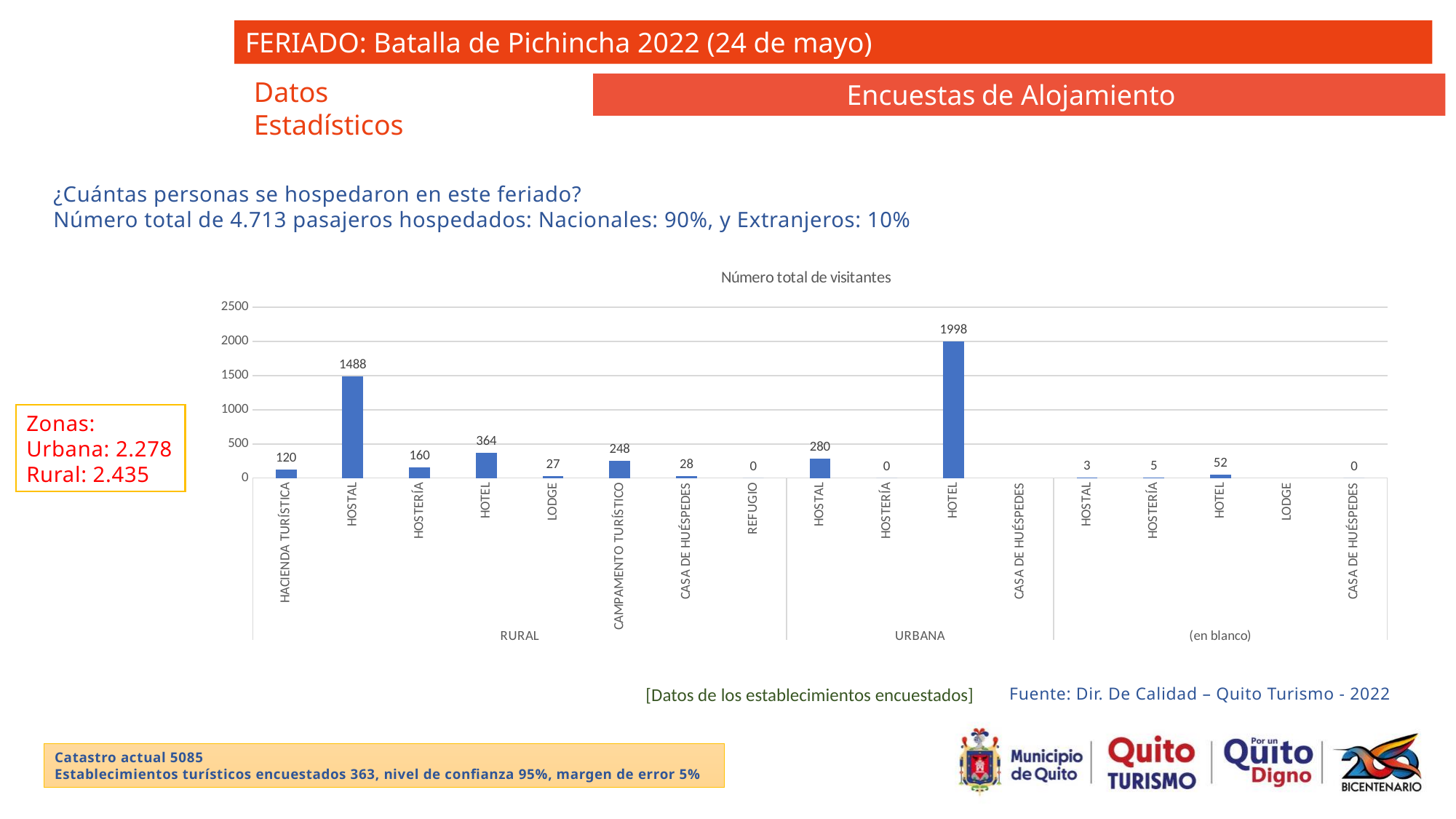
Which is larger: HOTEL in the RURAL group or HOSTAL in the URBANA group? HOTEL (RURAL) How many zone groups are shown along the x axis of the chart? 3 What type of chart is shown on the slide? bar chart What is the title of the chart? Número total de visitantes Which category has the highest value in the chart? HOTEL (URBANA) What is the difference between HOTEL in the URBANA group and HOSTAL in the RURAL group? 510 What is the value for HOSTAL in the RURAL group? 1488 Is the value for HOSTAL in the RURAL group greater or less than 1000? greater What is the difference between HOSTERÍA and HACIENDA TURÍSTICA in the RURAL group? 40 What is the value for CAMPAMENTO TURÍSTICO in the RURAL group? 248 What is the value for HOTEL in the (en blanco) group? 52 What is the value for HOTEL in the URBANA group? 1998